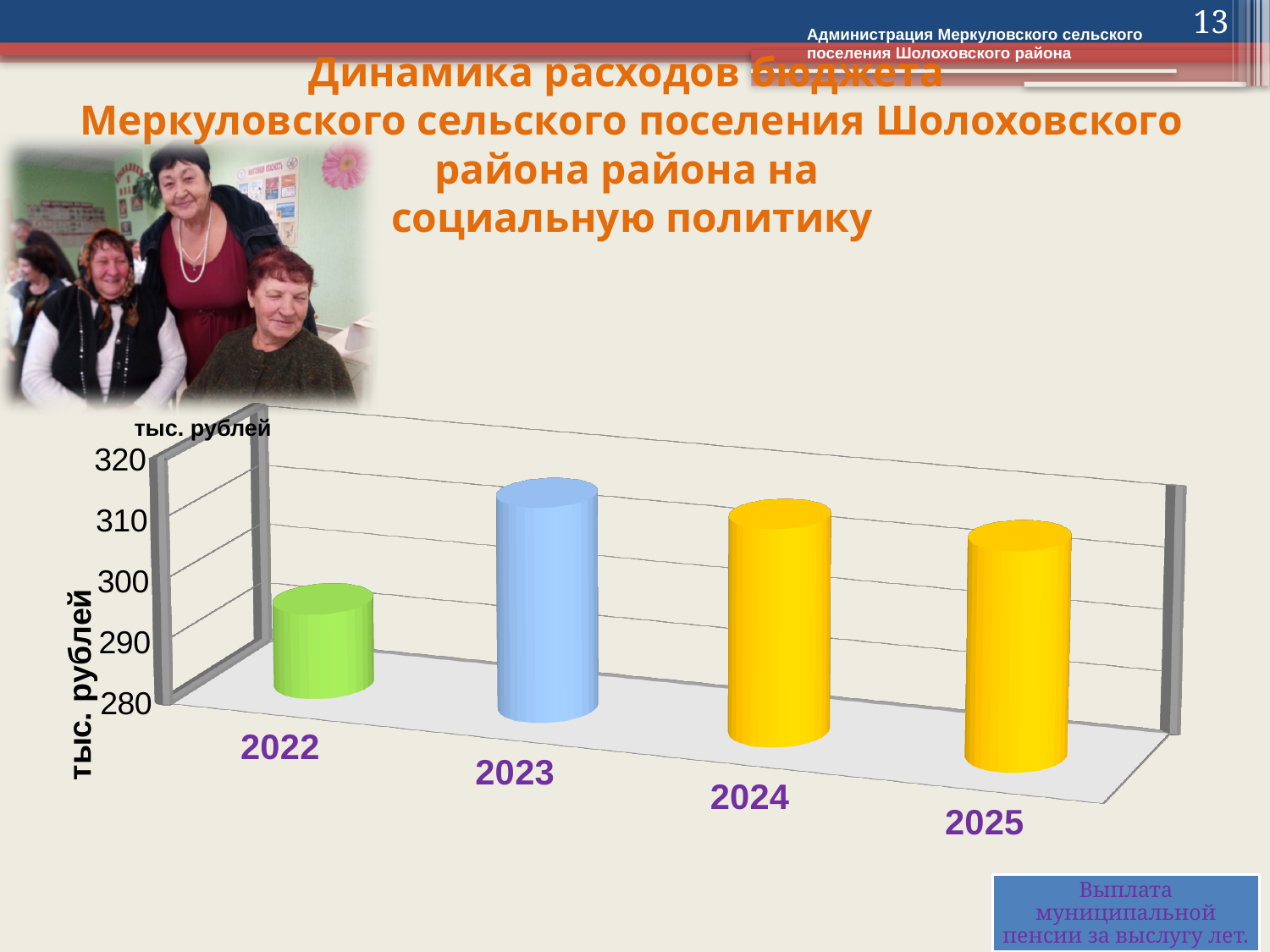
Which year has the lowest value in the chart? 2022 What unit is shown on the vertical axis of the chart? тыс. рублей Is the value for 2025 greater or less than 290? greater Is the value for 2022 greater or less than 310? less Is the value for 2023 greater or less than 300? greater How many years are shown on the x axis of the chart? 4 What kind of chart is shown on the slide? bar chart Which is larger, the value for 2023 or the value for 2022? 2023